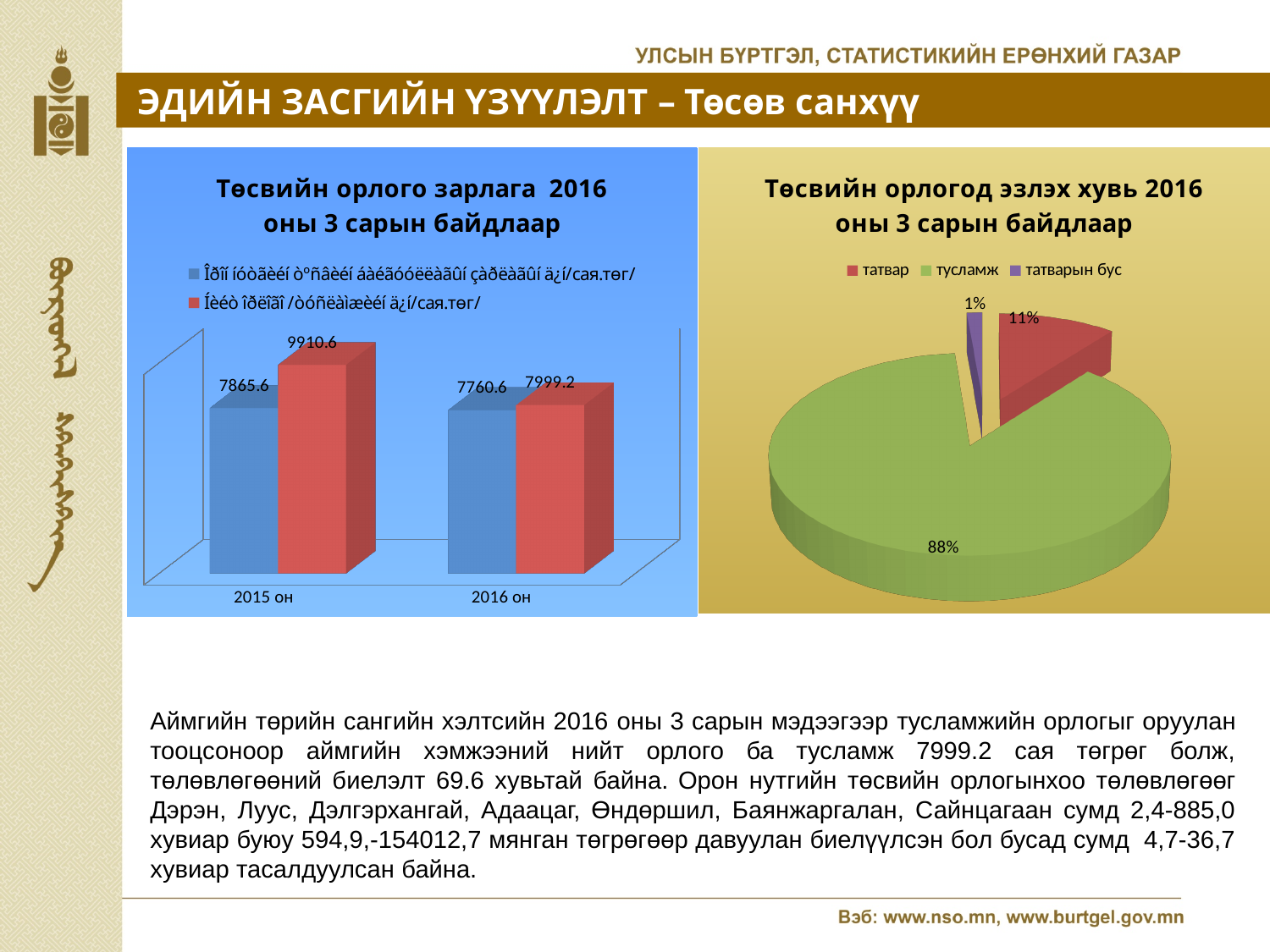
In the pie chart 'Төсвийн орлогод эзлэх хувь 2016 оны 3 сарын байдлаар', what share does тусламж have? 88% In the bar chart 'Төсвийн орлого зарлага 2016 оны 3 сарын байдлаар', what is the value of the blue bar for 2016 он? 7760.6 In the bar chart 'Төсвийн орлого зарлага 2016 оны 3 сарын байдлаар', what is the value of the red bar for 2015 он? 9910.6 In the pie chart 'Төсвийн орлогод эзлэх хувь 2016 оны 3 сарын байдлаар', what share does татвар have? 11% How many entries does the legend of the pie chart 'Төсвийн орлогод эзлэх хувь 2016 оны 3 сарын байдлаар' list? 3 What kind of chart is 'Төсвийн орлогод эзлэх хувь 2016 оны 3 сарын байдлаар'? Pie chart In the bar chart 'Төсвийн орлого зарлага 2016 оны 3 сарын байдлаар', what is the difference between the red and blue bars for 2015 он? 2045.0 In the bar chart 'Төсвийн орлого зарлага 2016 оны 3 сарын байдлаар', which bar is the highest of all? The red bar for 2015 он (9910.6) In the bar chart 'Төсвийн орлого зарлага 2016 оны 3 сарын байдлаар', does the blue bar rise or fall from 2015 он to 2016 он? Fall How many categories are shown on the x axis of the bar chart 'Төсвийн орлого зарлага 2016 оны 3 сарын байдлаар'? 2 In the pie chart 'Төсвийн орлогод эзлэх хувь 2016 оны 3 сарын байдлаар', which slice is the smallest? татварын бус In the bar chart 'Төсвийн орлого зарлага 2016 оны 3 сарын байдлаар', what is the value of the red bar for 2016 он? 7999.2